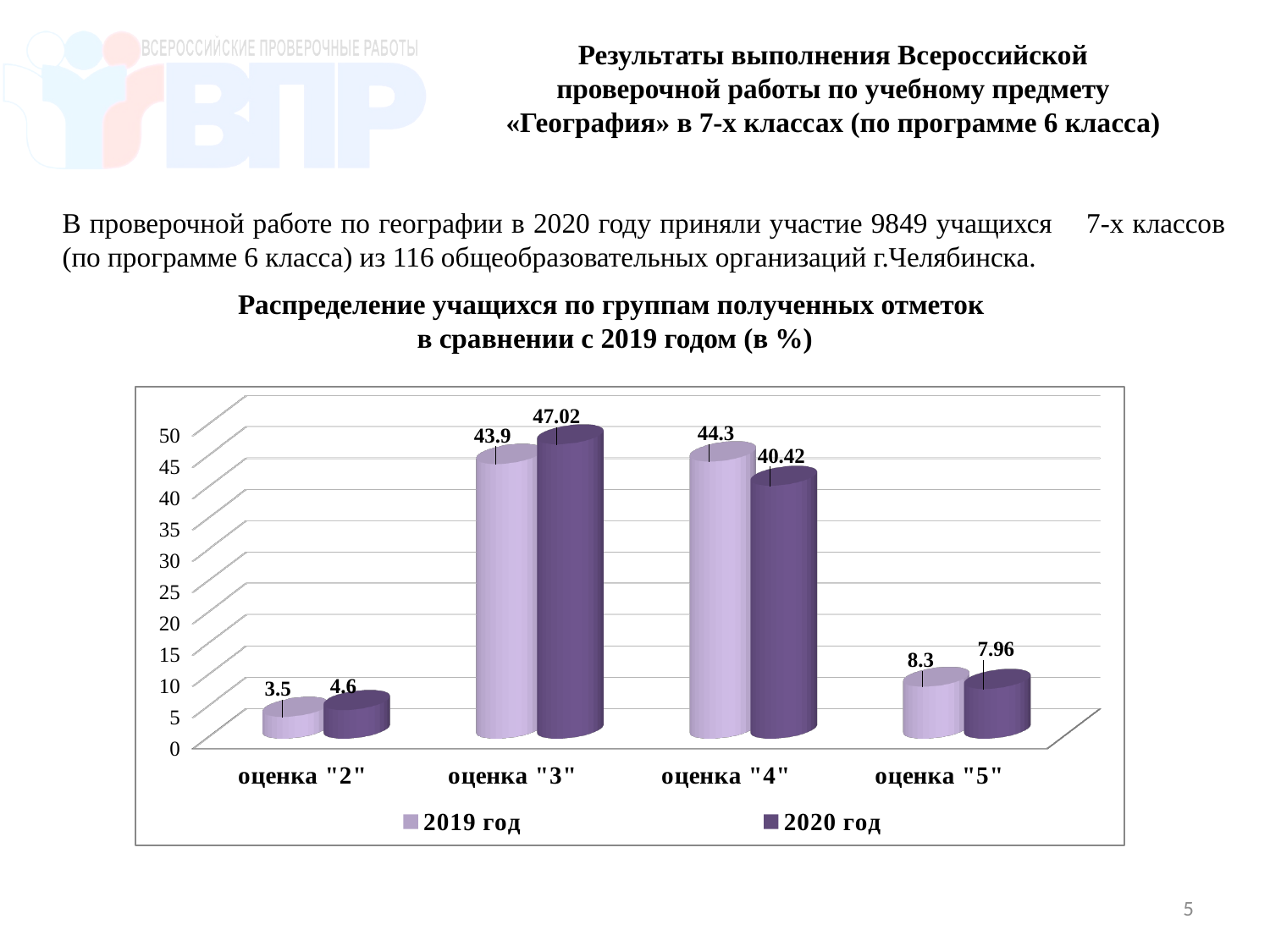
Which category has the lowest value in the 2019 год series? оценка "2" Which is larger for оценка "4": the 2019 год value or the 2020 год value? 2019 год Which category has the highest value in the 2020 год series? оценка "3" What is the value for оценка "3" in the 2020 год series? 47.02 What is the difference between the 2020 год and 2019 год values for оценка "3"? 3.12 What is the value for оценка "5" in the 2019 год series? 8.3 What is the value for оценка "4" in the 2019 год series? 44.3 What is the value for оценка "2" in the 2020 год series? 4.6 What kind of chart is shown on the slide? bar chart How many series does the legend list? 2 How many categories are shown on the x axis? 4 What are the two series named in the legend? 2019 год and 2020 год